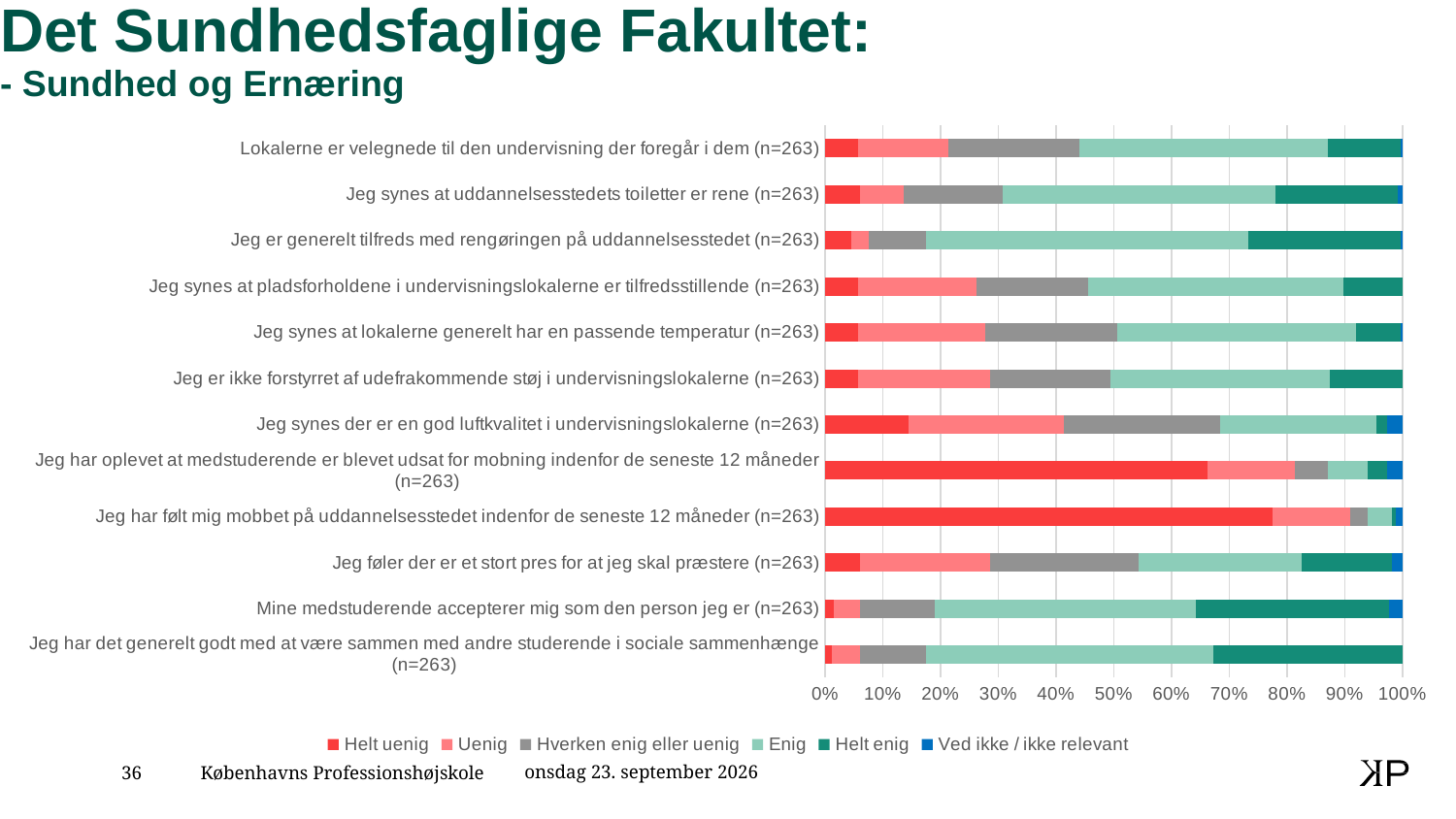
Is the 'Helt uenig' share for 'Lokalerne er velegnede til den undervisning der foregår i dem' greater or less than 10%? less What sample size (n) is shown for each statement in the chart? n=263 What kind of chart is shown on the slide? Stacked bar chart Which statement has the largest 'Helt uenig' segment? Jeg har følt mig mobbet på uddannelsesstedet indenfor de seneste 12 måneder (n=263) Is the 'Helt uenig' share for 'Jeg har oplevet at medstuderende er blevet udsat for mobning indenfor de seneste 12 måneder' greater or less than 60%? greater Is the 'Helt uenig' share for 'Jeg har følt mig mobbet på uddannelsesstedet indenfor de seneste 12 måneder' greater or less than 70%? greater Which has the larger 'Helt uenig' segment: 'Jeg har følt mig mobbet på uddannelsesstedet indenfor de seneste 12 måneder' or 'Jeg har oplevet at medstuderende er blevet udsat for mobning indenfor de seneste 12 måneder'? Jeg har følt mig mobbet på uddannelsesstedet indenfor de seneste 12 måneder How many series does the legend list? 6 What is the total of each stacked bar, as shown by the axis where the bars end? 100% How many statements (categories) are plotted in the chart? 12 Which has the larger 'Helt uenig' segment: 'Jeg synes der er en god luftkvalitet i undervisningslokalerne' or 'Jeg er generelt tilfreds med rengøringen på uddannelsesstedet'? Jeg synes der er en god luftkvalitet i undervisningslokalerne What is the first entry in the chart legend? Helt uenig